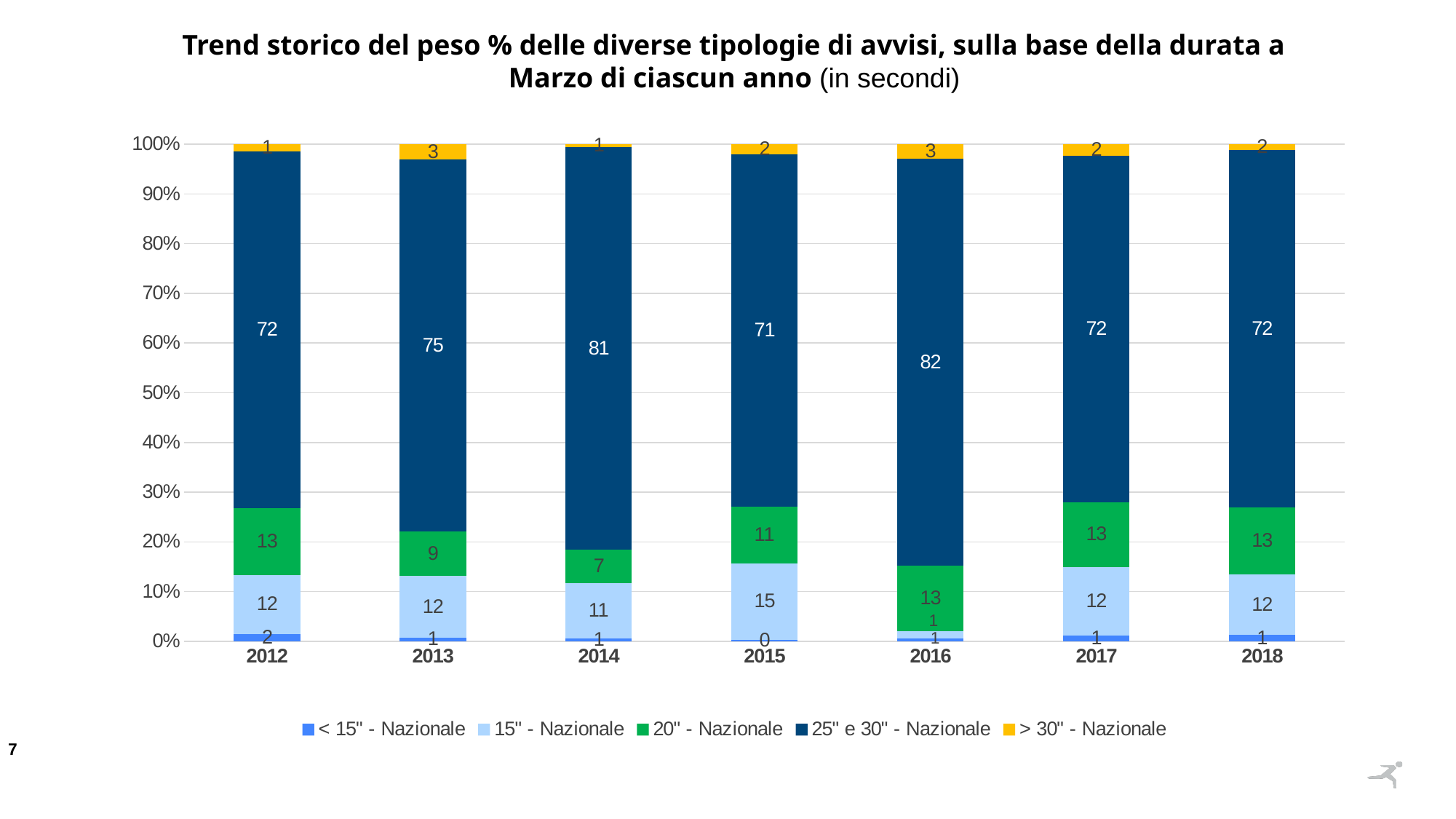
What kind of chart is shown on the slide? Stacked bar chart Which colour represents the > 30'' - Nazionale series? Yellow How many series does the legend list? 5 What is the value for the 15'' - Nazionale series in 2015? 15 What is the value for the 20'' - Nazionale series in 2014? 7 What is the difference between the 25'' e 30'' - Nazionale values in 2016 and 2015? 11 In which year is the 25'' e 30'' - Nazionale series lowest? 2015 What is the value for the > 30'' - Nazionale series in 2013? 3 What is the value for the 25'' e 30'' - Nazionale series in 2016? 82 How many years are shown on the x axis? 7 Which is larger, the 20'' - Nazionale value in 2012 or in 2013? 2012 In which year is the 25'' e 30'' - Nazionale series highest? 2016